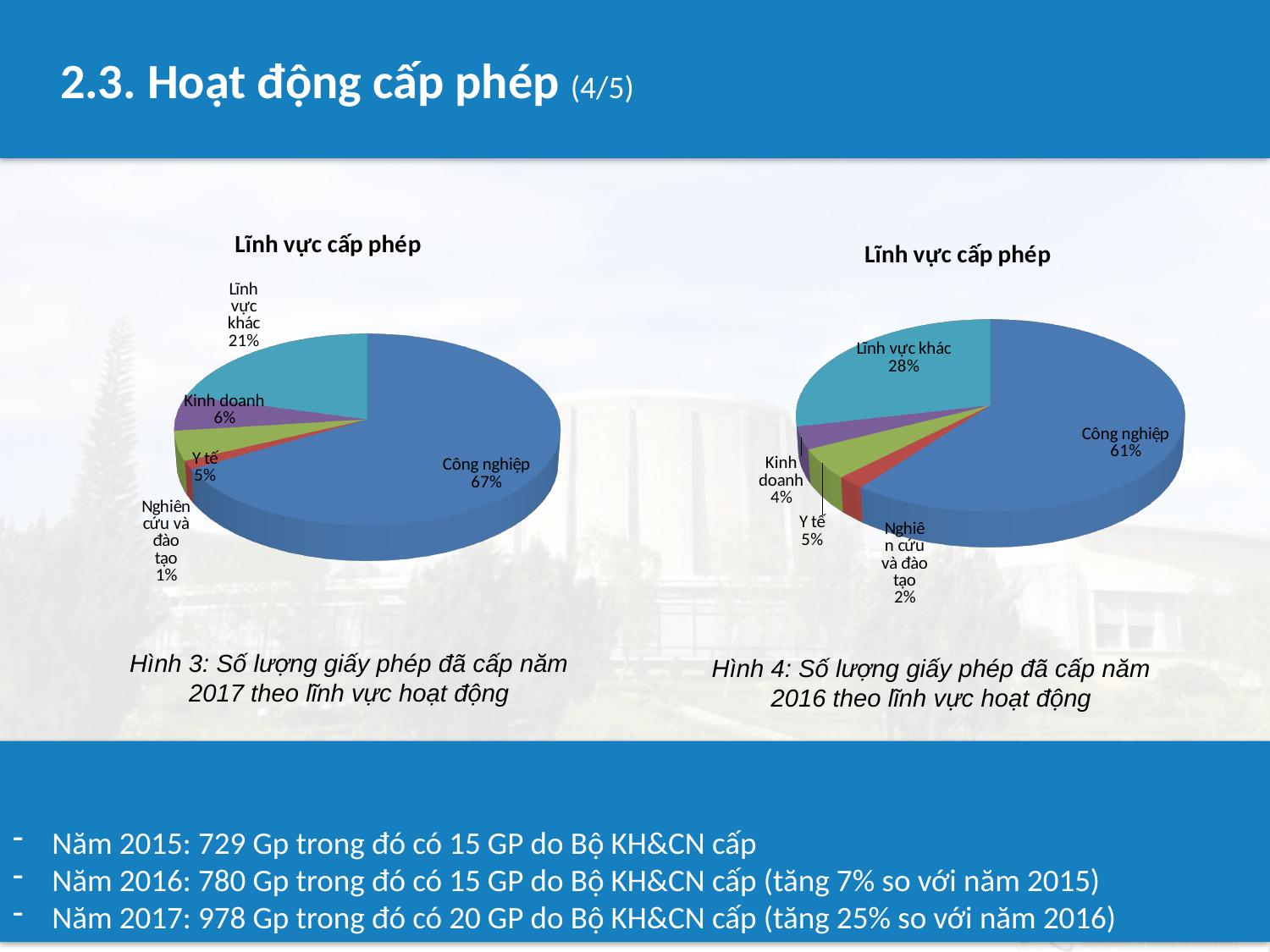
In the left pie chart (Hình 3, 2017), what is the difference between the shares of Công nghiệp and Lĩnh vực khác? 46% In the right pie chart (Hình 4, 2016), what share does Công nghiệp have? 61% In the right pie chart (Hình 4, 2016), which category has the largest share? Công nghiệp In the left pie chart (Hình 3, 2017), which category has the smallest share? Nghiên cứu và đào tạo What type of chart is used in Hình 4 on the right? Pie chart In the left pie chart (Hình 3, 2017), what share does Công nghiệp have? 67% In the right pie chart (Hình 4, 2016), what is the share for Nghiên cứu và đào tạo? 2% What is the title of the left pie chart? Lĩnh vực cấp phép How many categories are shown in the left pie chart (Hình 3, 2017)? 5 In the right pie chart (Hình 4, 2016), which is larger: Kinh doanh or Y tế? Y tế